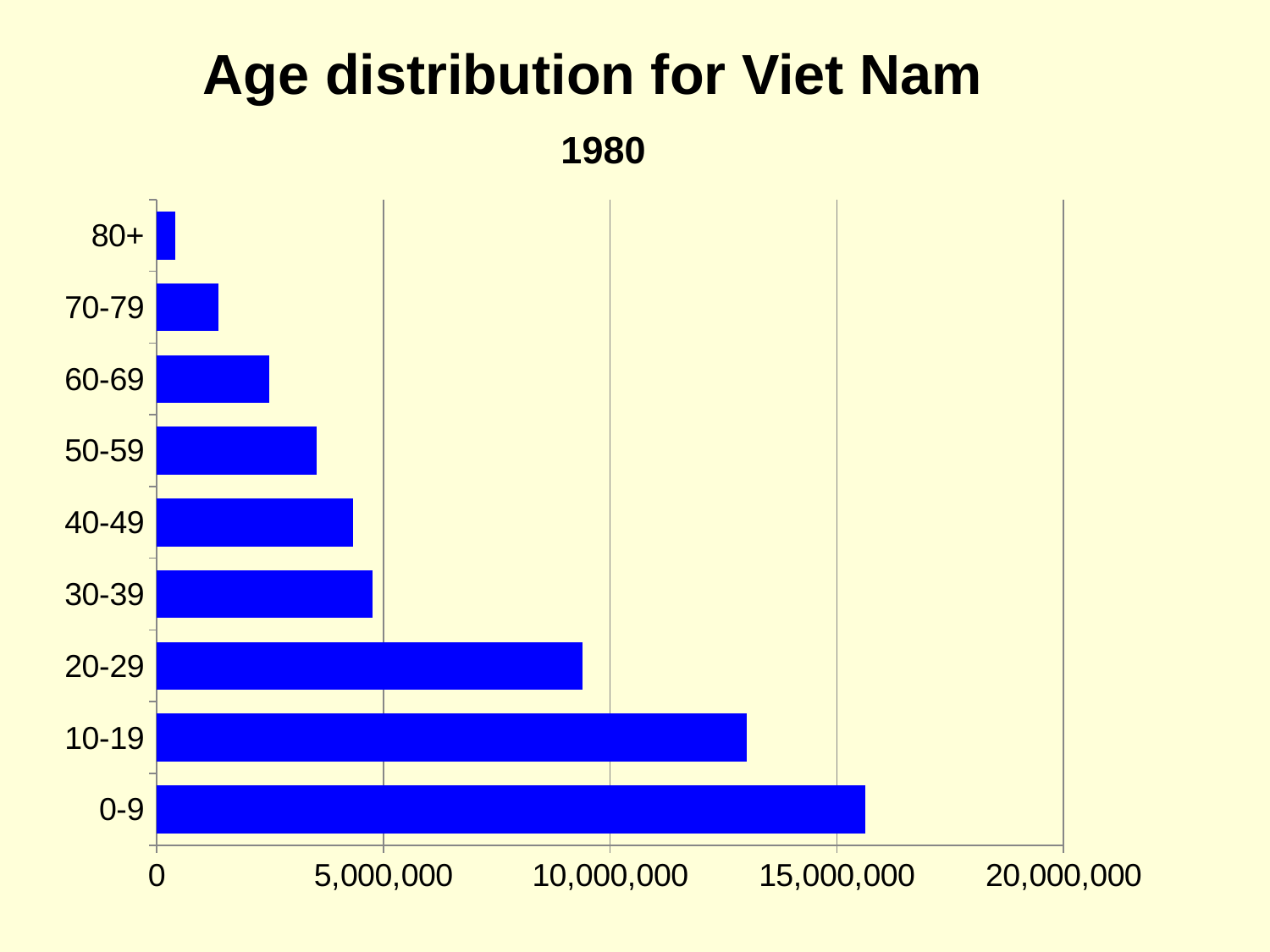
Which age group has the smallest population? 80+ What kind of chart is shown on the slide? bar chart Which age group has the larger population, 20-29 or 30-39? 20-29 Is the value for the 30-39 age group greater or less than 5,000,000? less Which age group has the larger population, 50-59 or 60-69? 50-59 Is the value for the 0-9 age group greater or less than 15,000,000? greater Do the bar values increase or decrease as the age groups get older, from 0-9 to 80+? decrease Which year does the chart show data for? 1980 Is the value for the 20-29 age group greater or less than 10,000,000? less How many age groups are plotted on the chart? 9 Which age group has the largest population? 0-9